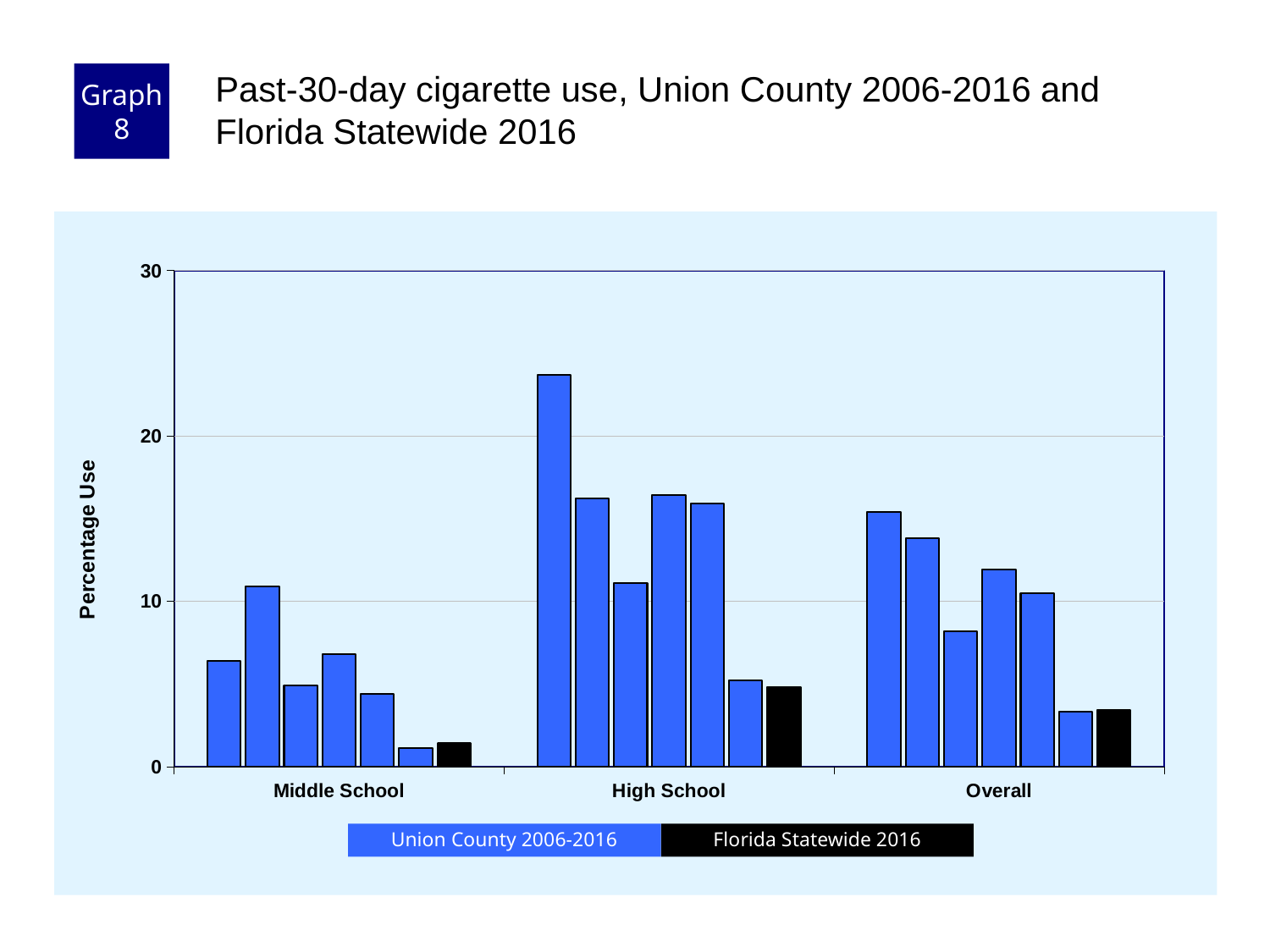
Which category has the lowest Florida Statewide 2016 value? Middle School Is the Florida Statewide 2016 value larger for High School or for Overall? High School Is the tallest Union County 2006-2016 bar for High School greater or less than 20? greater How many categories are shown on the x axis? 3 Which colour represents Florida Statewide 2016 in the legend? black What is the label on the y axis? Percentage Use Is the Florida Statewide 2016 value for High School greater or less than 10? less What kind of chart is shown on the slide? bar chart Is the first Union County 2006-2016 bar for Overall greater or less than 10? greater How many series does the legend list? 2 Which category has the tallest bar in the chart? High School